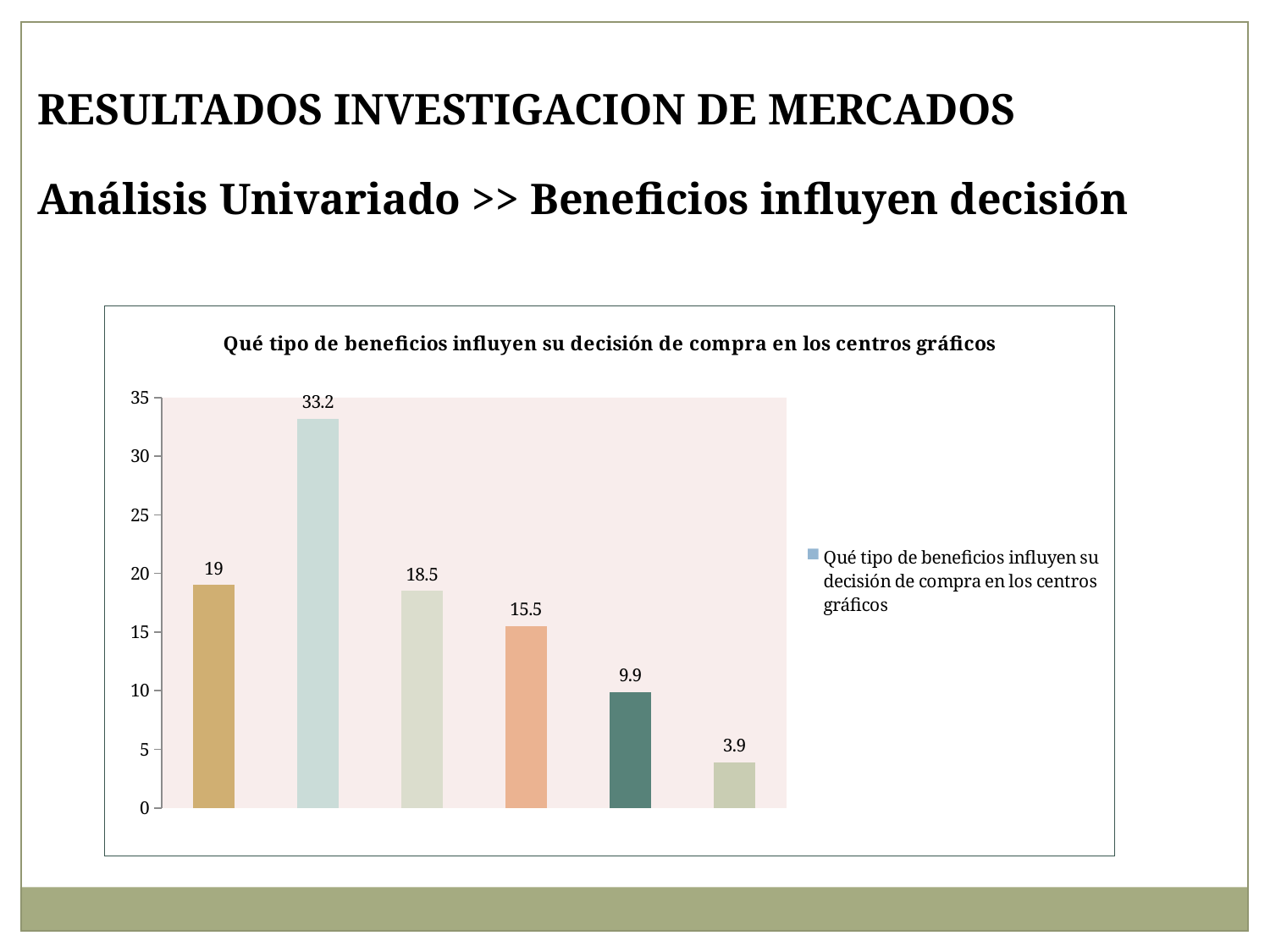
What is the value of the third bar from the left in the chart? 18.5 How many series does the legend list? 1 What is the value of the first (leftmost) bar in the chart? 19 Which is larger, the first bar (19) or the fourth bar (15.5)? the first bar (19) What is the value of the tallest bar in the chart? 33.2 What is the value of the shortest bar in the chart? 3.9 Do the bar values rise or fall from the third bar to the sixth bar? fall How many bars are plotted in the chart? 6 What is the value of the dark teal bar (fifth from the left)? 9.9 What is the difference between the tallest bar (33.2) and the shortest bar (3.9)? 29.3 What kind of chart is shown on the slide? bar chart What is the title of the chart? Qué tipo de beneficios influyen su decisión de compra en los centros gráficos